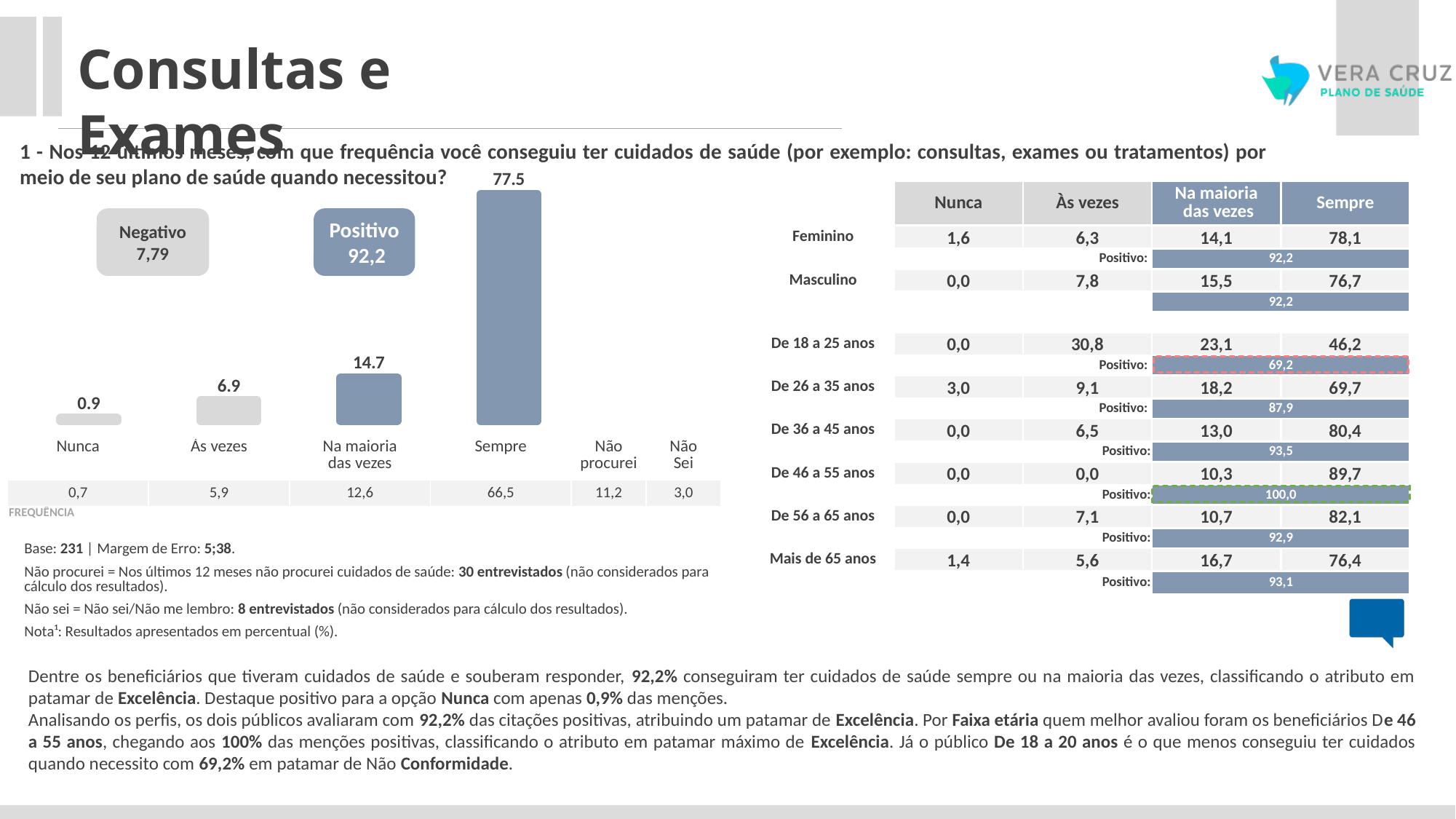
What is the value of the bar for Nunca? 0.9 Which category has the lowest bar? Nunca What is the difference between the values for Na maioria das vezes and Às vezes? 7.8 Which category has the highest bar? Sempre What is the difference between the values for Sempre and Na maioria das vezes? 62.8 Which is larger, the value for Às vezes or the value for Na maioria das vezes? Na maioria das vezes Do the bar values rise or fall going from Nunca to Sempre along the x axis? Rise What is the value of the bar for Sempre? 77.5 What kind of chart is shown on the left of the slide? Bar chart What value is shown in the Positivo box above the chart? 92,2 What is the value of the bar for Às vezes? 6.9 What is the value of the bar for Na maioria das vezes? 14.7